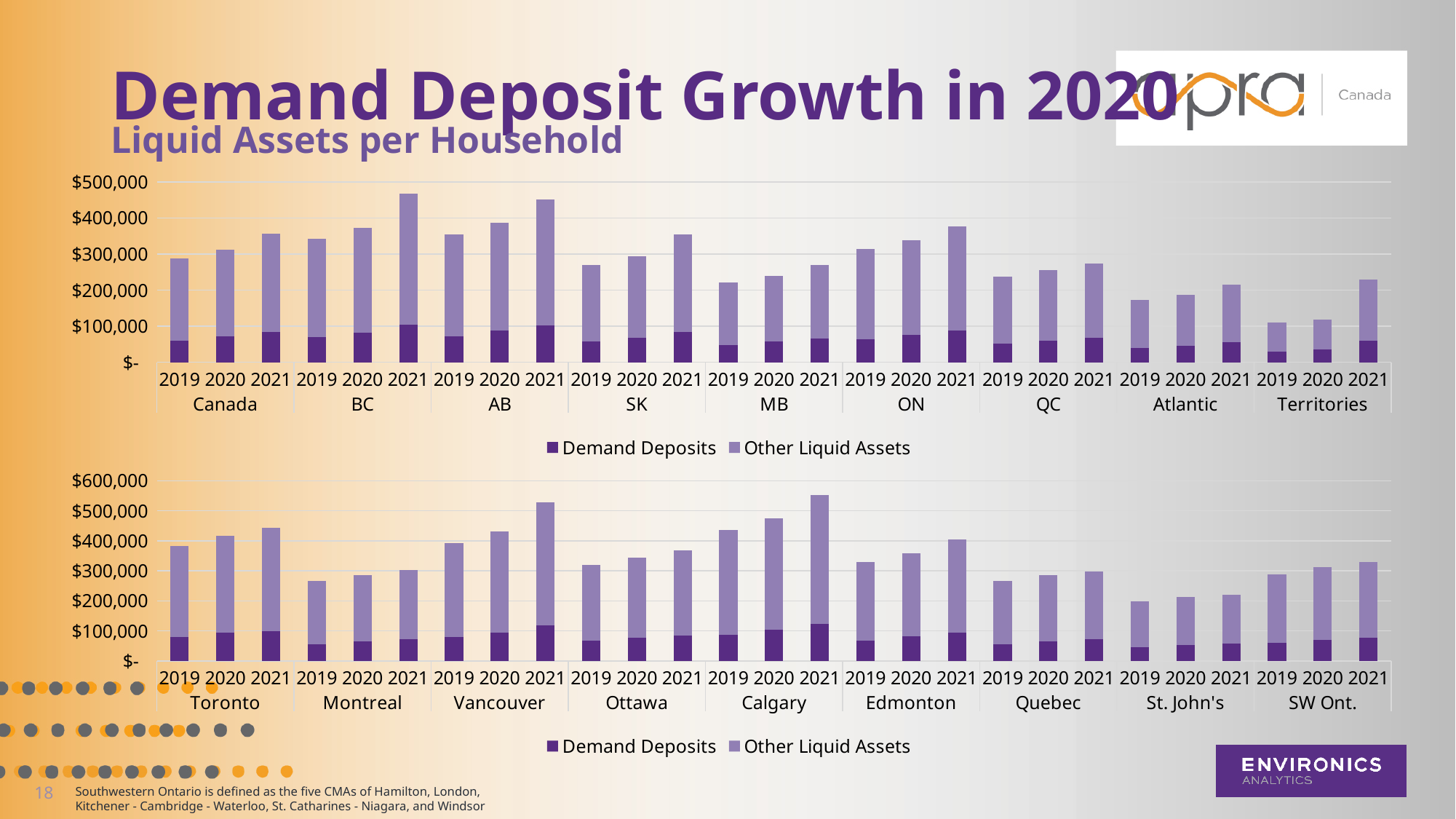
What are the two legend entries in the bottom chart? Demand Deposits and Other Liquid Assets In the bottom chart, is the total for Toronto in 2021 greater or less than $400,000? greater In the top chart, how many regions are shown along the x axis? 9 In the bottom chart, which has the larger total in 2021, Calgary or Edmonton? Calgary What kind of chart is the top chart on the slide? Stacked bar chart In the bottom chart, how many cities are shown along the x axis? 9 In the top chart, is the total for Canada in 2019 greater or less than $300,000? less How many series does the legend of the top chart list? 2 In the top chart, is the total for Territories in 2021 greater or less than $200,000? greater In the bottom chart, which city and year has the tallest bar? Calgary 2021 In the top chart, which region and year has the tallest bar? BC 2021 In the top chart, do the total liquid assets for Canada rise or fall from 2019 to 2021? rise